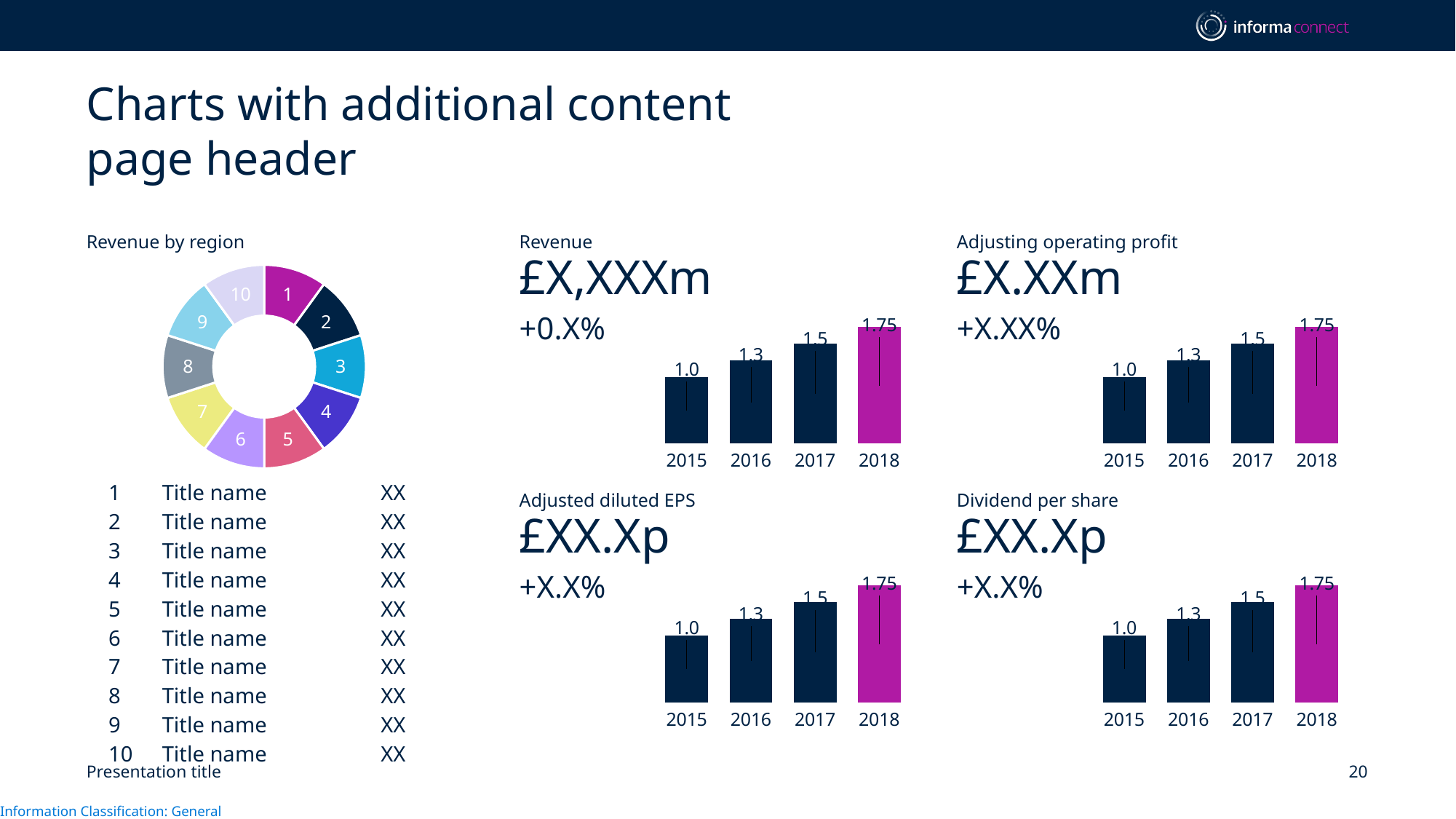
What kind of chart is the Revenue by region chart? donut chart How many years are shown on the x axis of the Dividend per share chart? 4 In the Revenue chart, which year has the highest value? 2018 How many segments does the Revenue by region chart have? 10 In the Dividend per share chart, what is the value for 2017? 1.5 In the Adjusted diluted EPS chart, what is the value for 2015? 1.0 In the Revenue chart, what is the value for 2018? 1.75 In the Adjusting operating profit chart, what is the value for 2016? 1.3 In the Adjusting operating profit chart, what is the difference between the 2018 and 2015 values? 0.75 In the Revenue chart, do the values rise or fall from 2015 to 2018? rise In the Dividend per share chart, which year has the lowest value? 2015 In the Adjusted diluted EPS chart, which is larger, the value for 2016 or the value for 2017? 2017